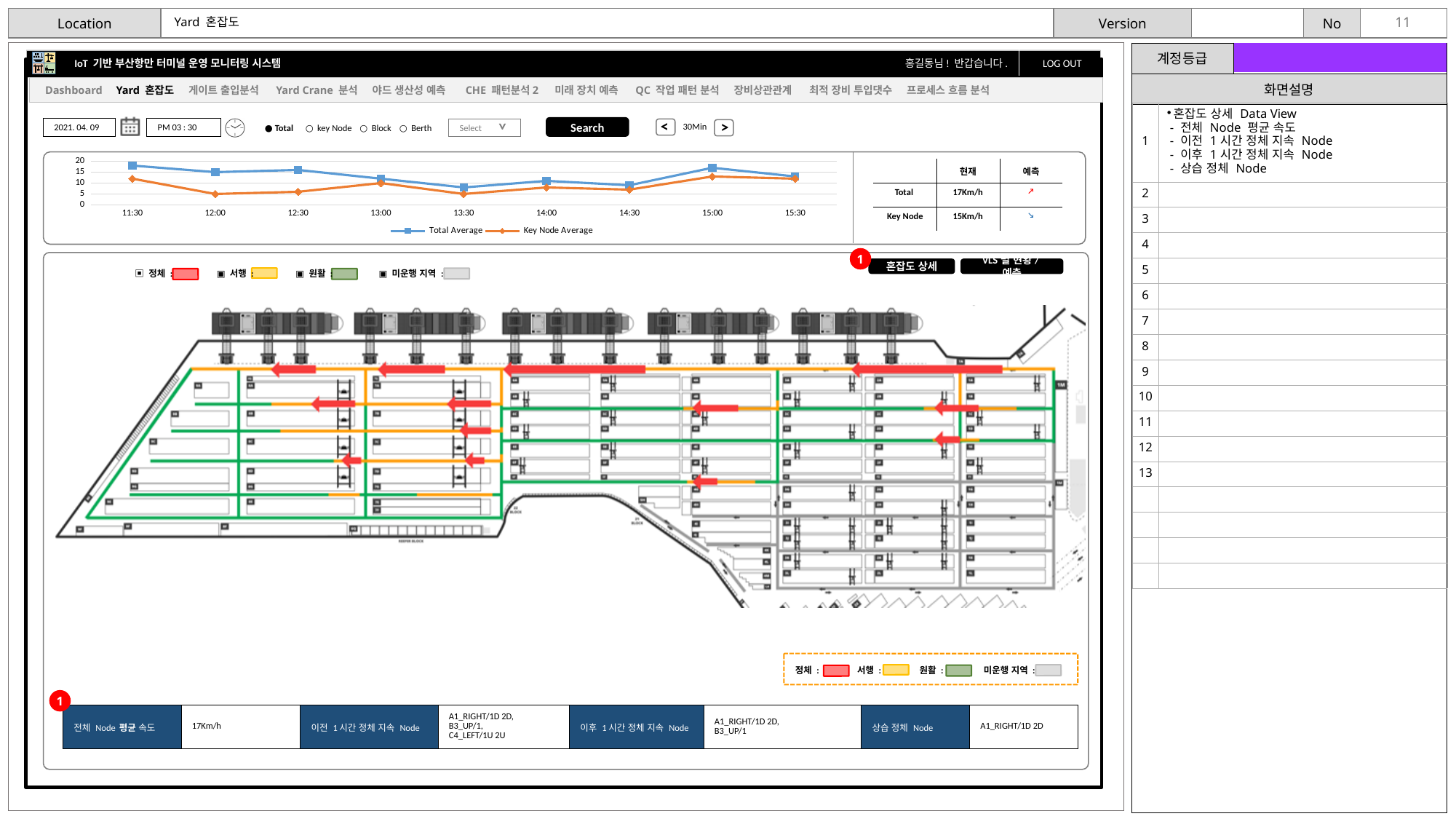
How many series does the legend of the line chart list? 2 Does the Key Node Average line rise or fall from 14:30 to 15:00? Rise At 11:30, which series has the larger value, Total Average or Key Node Average? Total Average What are the two series named in the line chart legend? Total Average and Key Node Average Is the Total Average value at 11:30 greater or less than 15? greater Is the Key Node Average value at 15:00 greater or less than 10? greater How many time points are shown along the x axis of the line chart? 9 Is the Total Average value at 13:30 greater or less than 10? less What kind of chart is shown at the top of the dashboard? Line chart Does the Total Average line rise or fall from 11:30 to 13:30? Fall What is the first time label on the x axis of the line chart? 11:30